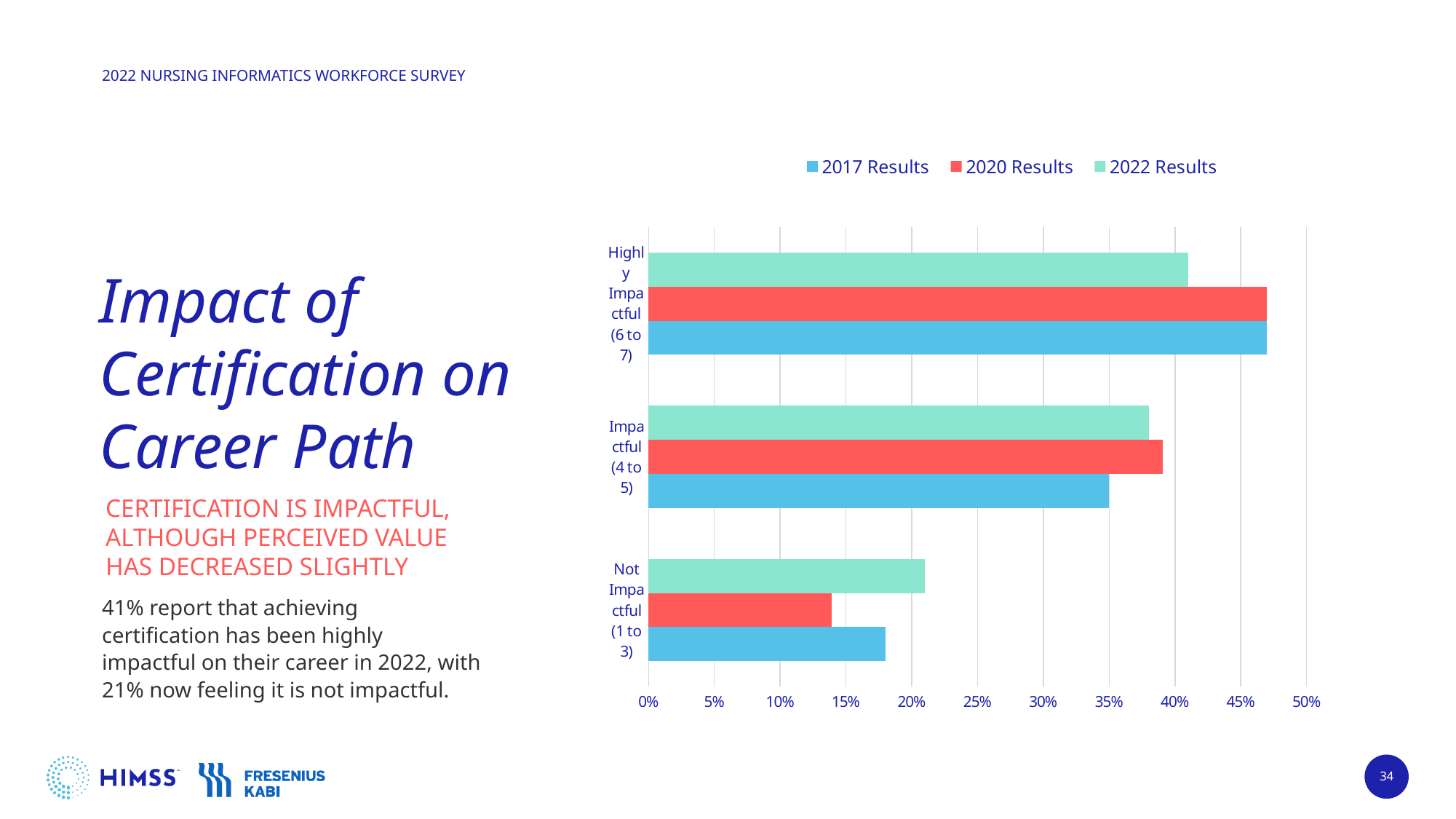
Is the 2017 Results value for Highly Impactful (6 to 7) greater or less than 45%? greater What kind of chart is shown on the slide? bar chart Is the 2017 Results value for Not Impactful (1 to 3) greater or less than 20%? less Which colour represents the 2020 Results series? red According to the slide, what percentage reported certification was highly impactful in 2022? 41% How many categories are shown on the chart? 3 Which series has the lowest value for Highly Impactful (6 to 7)? 2022 Results Which series has the highest value for Not Impactful (1 to 3)? 2022 Results Is the 2020 Results value for Not Impactful (1 to 3) greater or less than 15%? less How many series does the legend list? 3 According to the slide, what percentage felt certification was not impactful in 2022? 21%